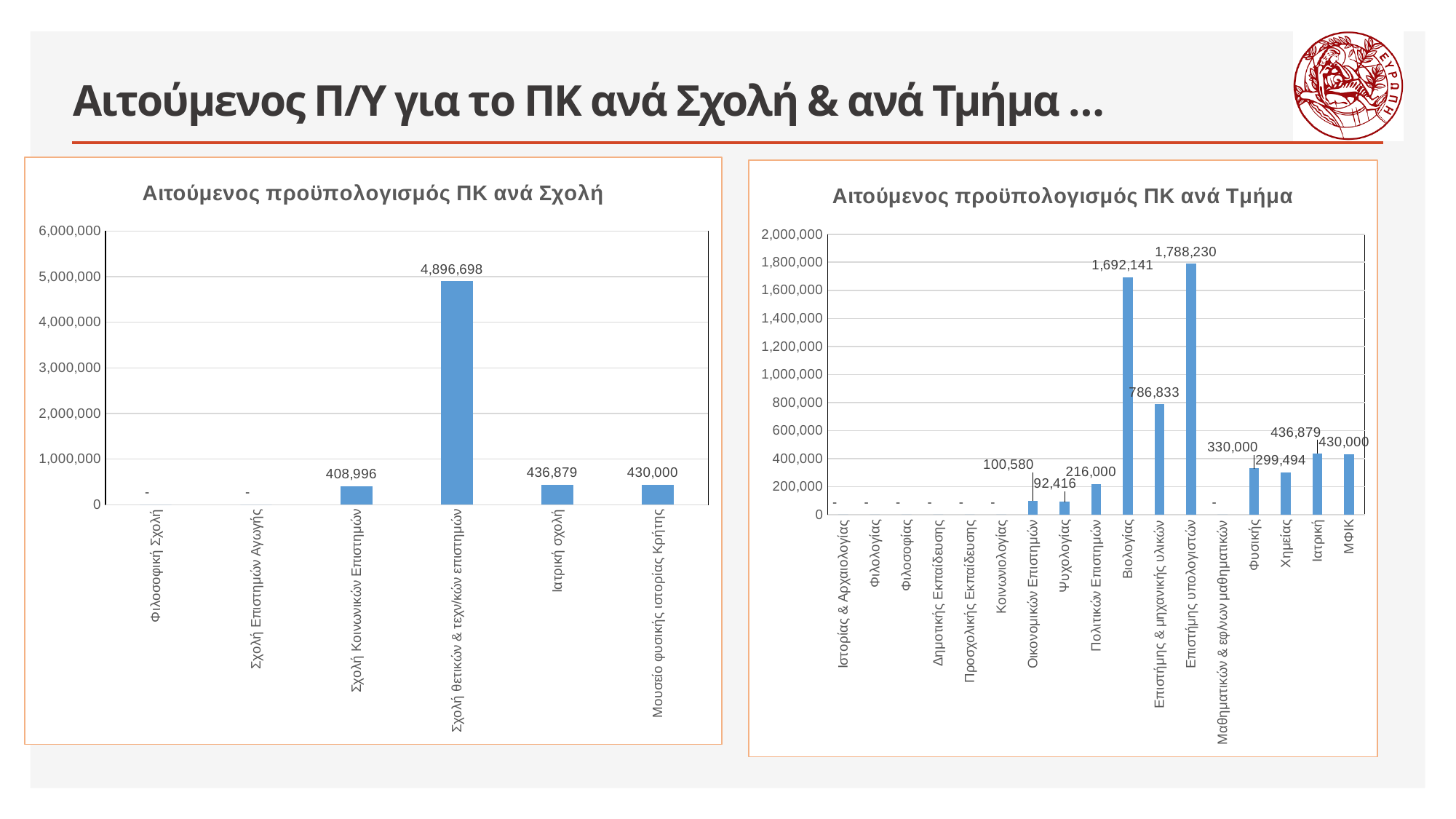
What kind of chart is 'Αιτούμενος προϋπολογισμός ΠΚ ανά Τμήμα'? Bar chart In the chart 'Αιτούμενος προϋπολογισμός ΠΚ ανά Τμήμα', which is larger: Οικονομικών Επιστημών or Ψυχολογίας? Οικονομικών Επιστημών In the chart 'Αιτούμενος προϋπολογισμός ΠΚ ανά Τμήμα', what is the value for Χημείας? 299,494 In the chart 'Αιτούμενος προϋπολογισμός ΠΚ ανά Τμήμα', what is the value for Βιολογίας? 1,692,141 In the chart 'Αιτούμενος προϋπολογισμός ΠΚ ανά Σχολή', how many categories are shown on the x axis? 6 In the chart 'Αιτούμενος προϋπολογισμός ΠΚ ανά Τμήμα', which department has the highest value? Επιστήμης υπολογιστών In the chart 'Αιτούμενος προϋπολογισμός ΠΚ ανά Σχολή', what is the value for Σχολή Κοινωνικών Επιστημών? 408,996 In the chart 'Αιτούμενος προϋπολογισμός ΠΚ ανά Σχολή', what is the difference between Ιατρική σχολή and Μουσείο φυσικής ιστορίας Κρήτης? 6,879 In the chart 'Αιτούμενος προϋπολογισμός ΠΚ ανά Σχολή', what is the value for Σχολή Θετικών & τεχν/κών επιστημών? 4,896,698 In the chart 'Αιτούμενος προϋπολογισμός ΠΚ ανά Τμήμα', how many categories are shown on the x axis? 17 In the chart 'Αιτούμενος προϋπολογισμός ΠΚ ανά Σχολή', which category has the highest value? Σχολή Θετικών & τεχν/κών επιστημών In the chart 'Αιτούμενος προϋπολογισμός ΠΚ ανά Τμήμα', what is the difference between Επιστήμης υπολογιστών and Βιολογίας? 96,089